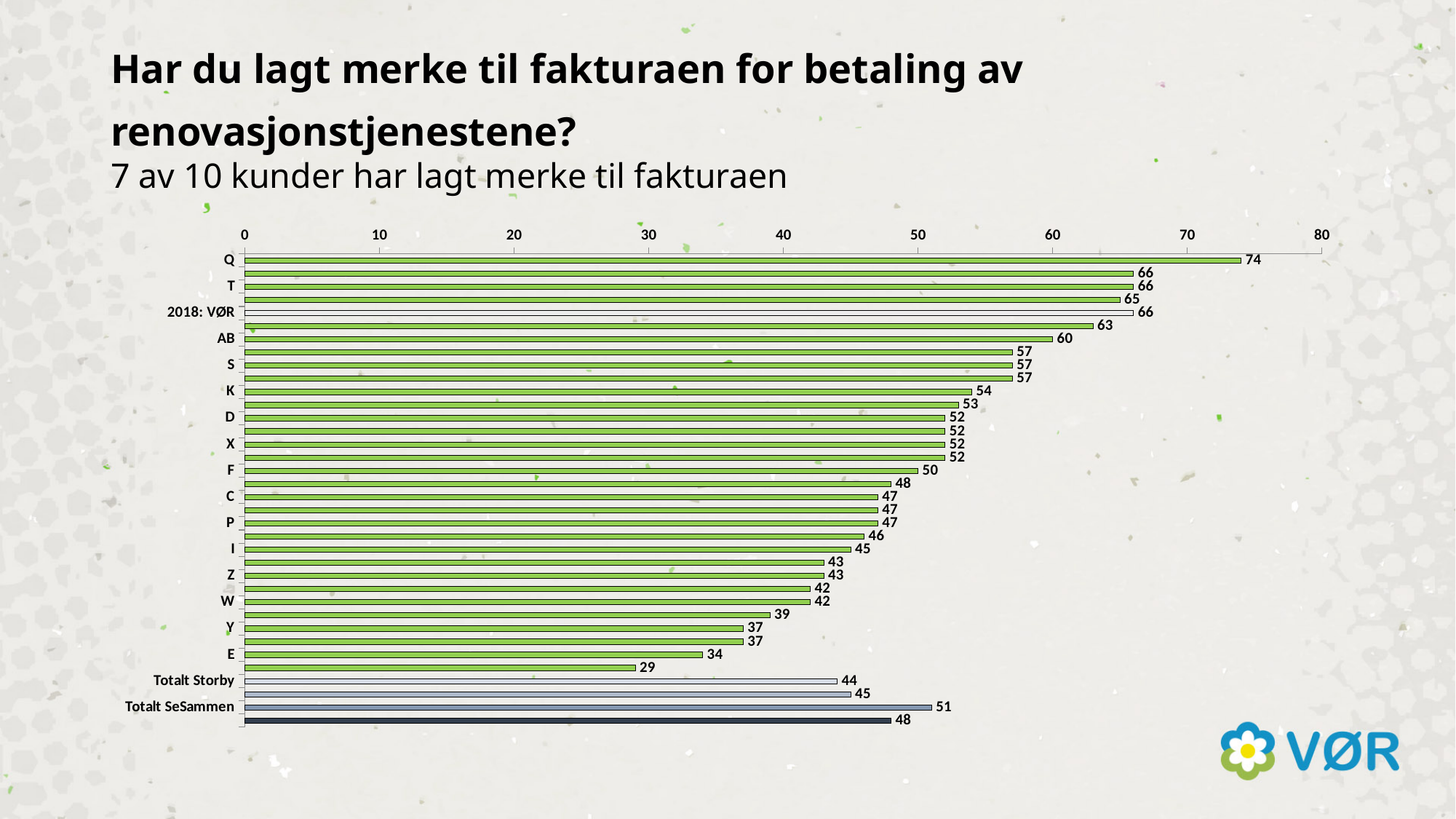
What is the value for E? 34 Is the value for Y greater or less than 40? less What is the value for AB? 60 What is the value for 2018: VØR? 66 What is the value for Totalt SeSammen? 51 Which is larger, the value for K or the value for F? K What is the value for K? 54 What is the value for Totalt Storby? 44 What is the difference between the values for Q and AB? 14 What is the value for Q? 74 Which category has the highest value? Q What kind of chart is shown on the slide? bar chart